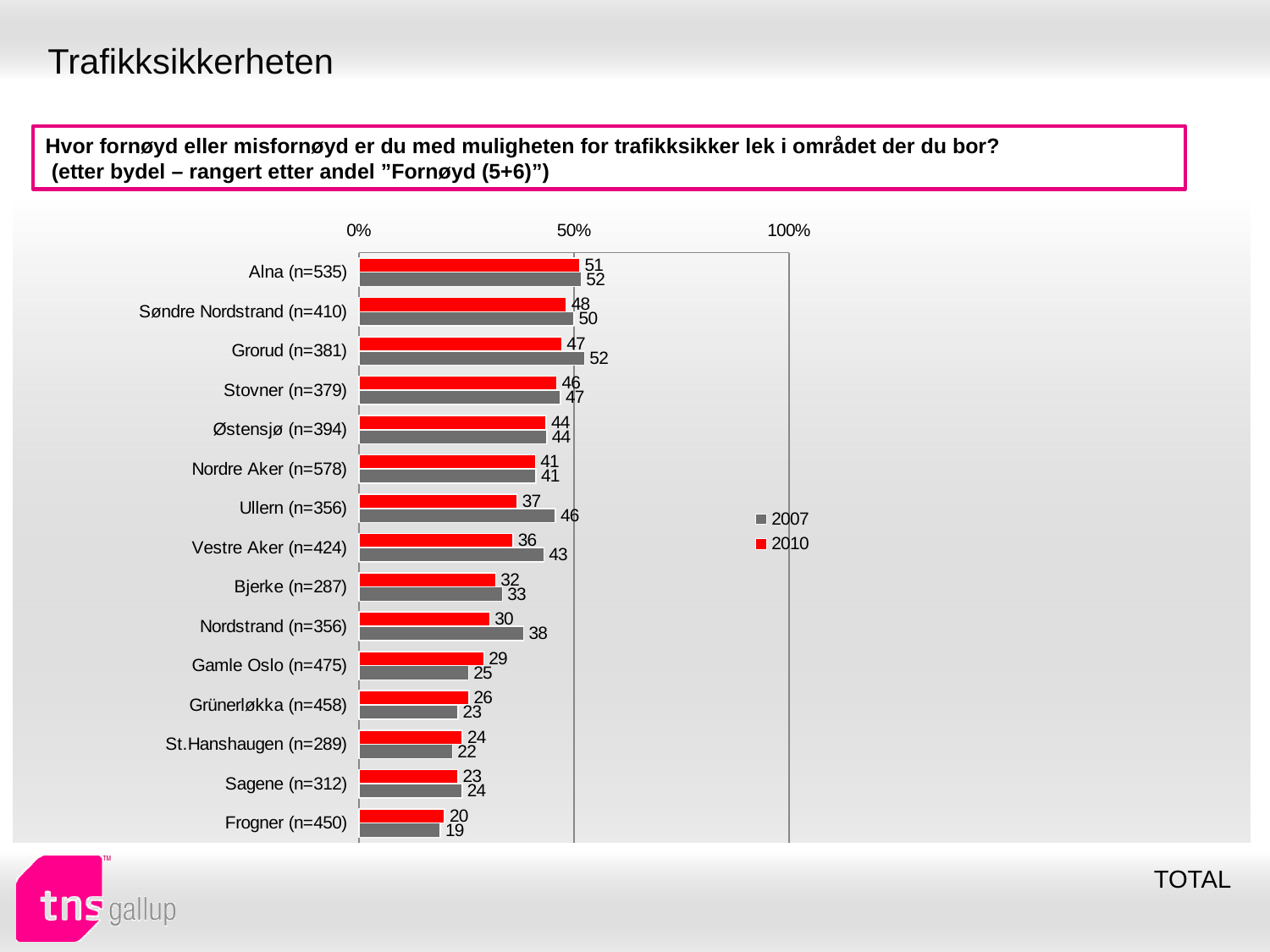
What kind of chart is shown on the slide? Bar chart How many series does the legend list? 2 How many districts are shown on the chart? 15 What is the 2010 value for Vestre Aker (n=424)? 36 What is the 2007 value for Nordstrand (n=356)? 38 Which district has the highest 2010 value? Alna (n=535) For Gamle Oslo (n=475), which is larger, the 2007 value or the 2010 value? 2010 What is the 2007 value for Grorud (n=381)? 52 What is the 2010 value for Alna (n=535)? 51 What is the difference between the 2007 and 2010 values for Ullern (n=356)? 9 Which series is shown in red? 2010 Which district has the lowest 2010 value? Frogner (n=450)